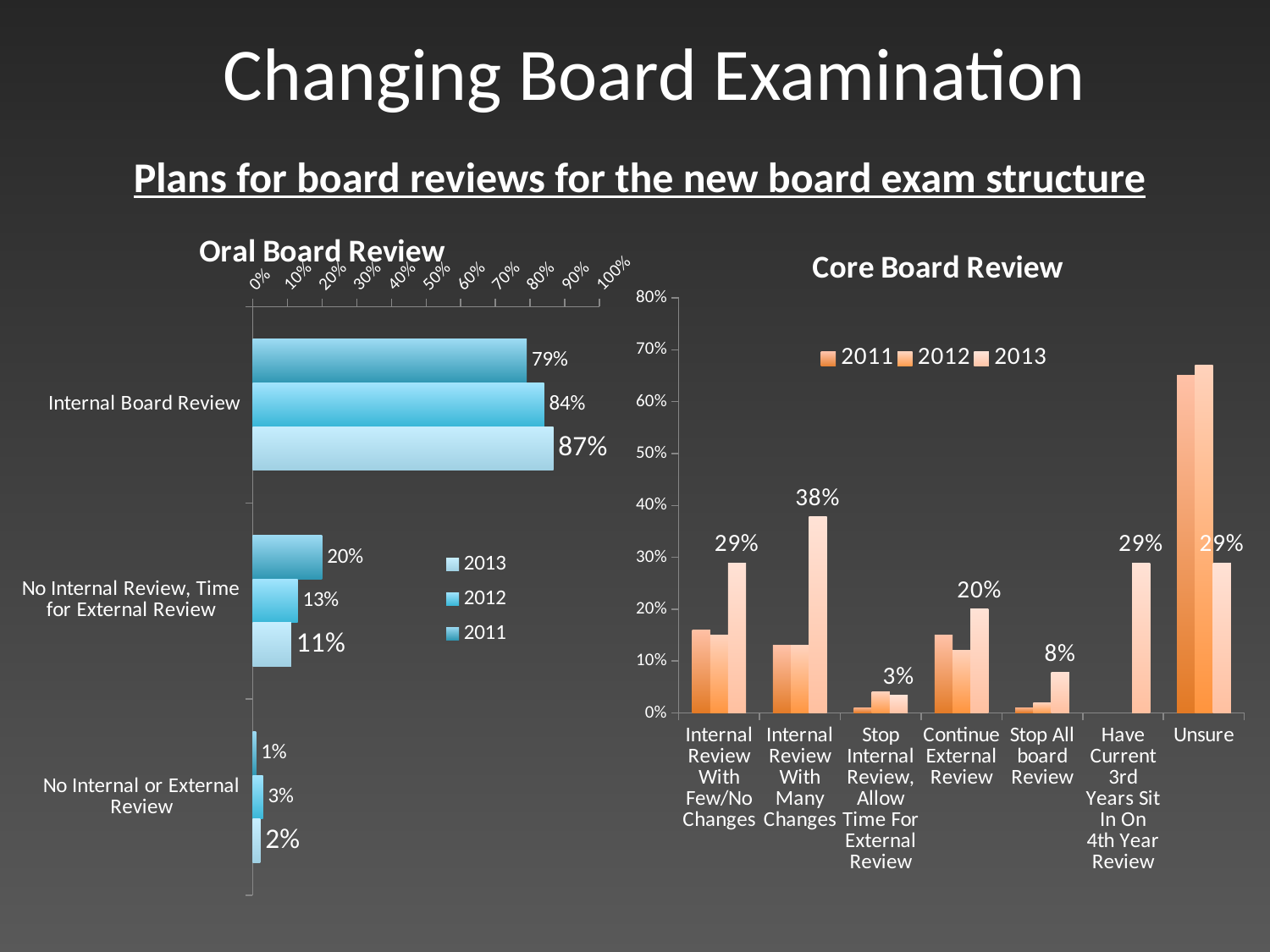
In the Core Board Review chart, what is the 2013 value for Stop All board Review? 8% In the Core Board Review chart, is the 2011 value for Unsure greater or less than 60%? greater In the Oral Board Review chart, what is the 2013 value for Internal Board Review? 87% What kind of chart is the Oral Board Review chart? bar chart In the Core Board Review chart, what is the 2013 value for Internal Review With Many Changes? 38% How many series does the legend of the Core Board Review chart list? 3 In the Core Board Review chart, which category has the lowest 2013 value? Stop Internal Review, Allow Time For External Review How many categories are shown on the x axis of the Core Board Review chart? 7 In the Oral Board Review chart, what is the difference between the 2013 and 2011 values for Internal Board Review? 8 percentage points In the Core Board Review chart, which category has the highest 2013 value? Internal Review With Many Changes How many categories are shown in the Oral Board Review chart? 3 In the Core Board Review chart, what is the difference between the 2013 values for Internal Review With Many Changes and Continue External Review? 18 percentage points